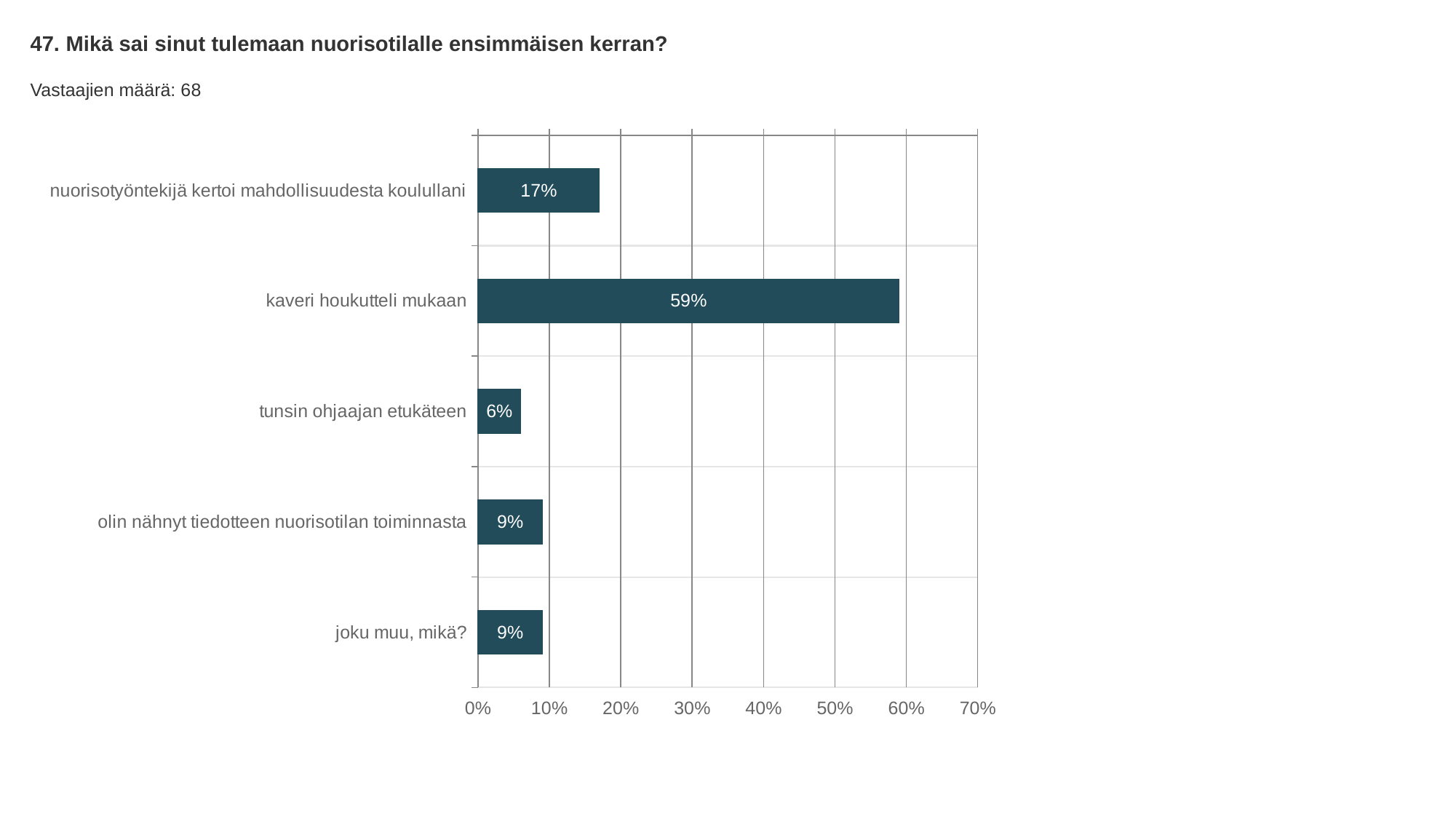
Which category has the highest percentage? kaveri houkutteli mukaan Which is larger, the value for "nuorisotyöntekijä kertoi mahdollisuudesta koulullani" or the value for "joku muu, mikä?"? nuorisotyöntekijä kertoi mahdollisuudesta koulullani How many respondents (Vastaajien määrä) are reported on the slide? 68 What kind of chart is shown on the slide? bar chart What percentage is shown for "nuorisotyöntekijä kertoi mahdollisuudesta koulullani"? 17% How many categories are shown in the chart? 5 What percentage is shown for "tunsin ohjaajan etukäteen"? 6% Which category has the lowest percentage? tunsin ohjaajan etukäteen What is the difference in percentage points between "kaveri houkutteli mukaan" and "nuorisotyöntekijä kertoi mahdollisuudesta koulullani"? 42 Is the value for "kaveri houkutteli mukaan" greater or less than 50%? greater What percentage is shown for "kaveri houkutteli mukaan"? 59% What percentage is shown for "olin nähnyt tiedotteen nuorisotilan toiminnasta"? 9%